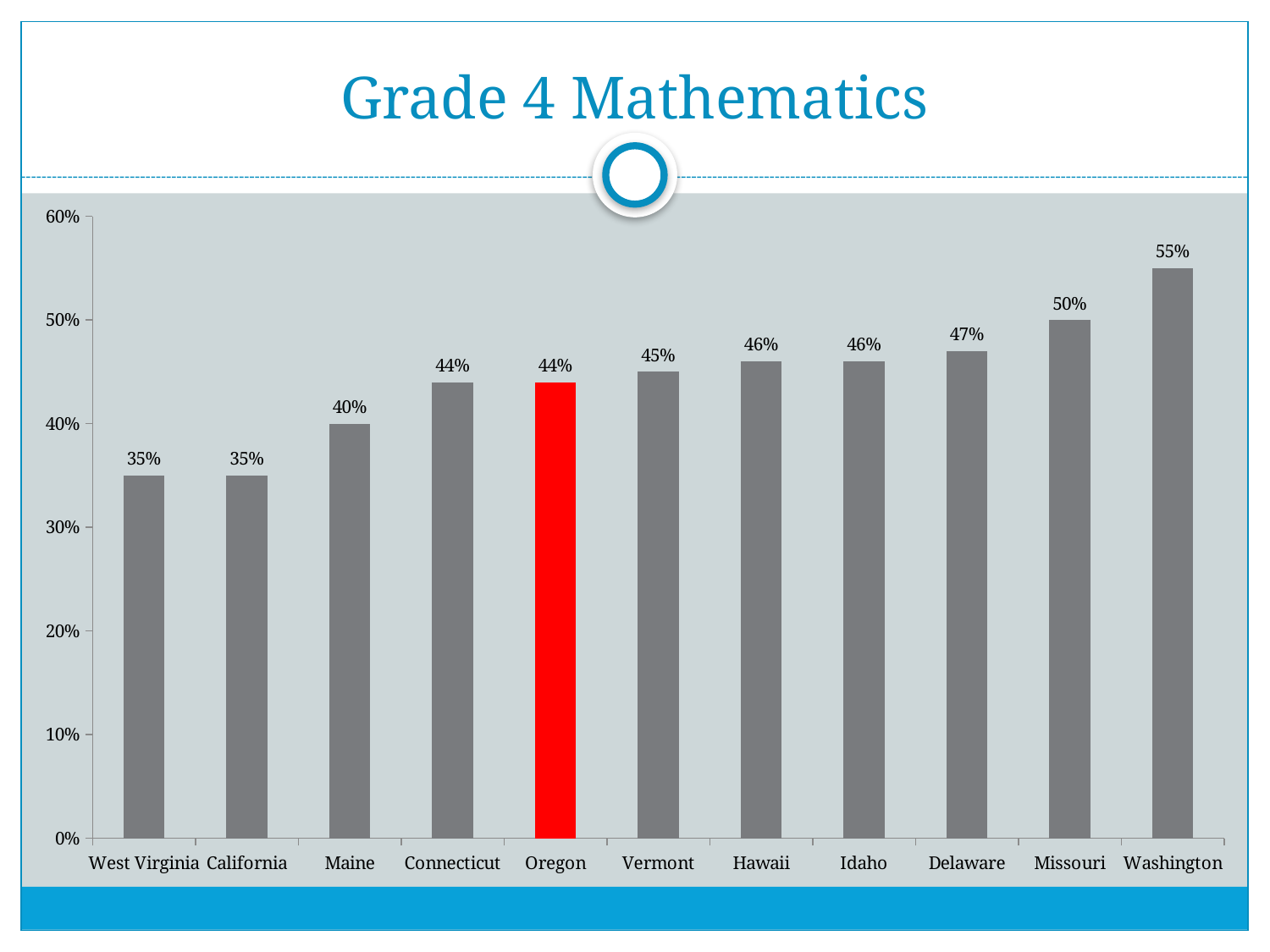
What is the difference between the values for Missouri and Maine? 10% Do the values generally rise or fall from left to right along the x axis? rise What is the value for Oregon? 44% How many states are shown on the chart? 11 Which is larger, the value for Delaware or the value for Vermont? Delaware What kind of chart is shown on the slide? bar chart What is the value for Washington? 55% Is the value for Missouri greater or less than 40%? greater What is the difference between the values for Washington and Oregon? 11% What is the value for Maine? 40% Which state has the highest value? Washington Which state's bar is coloured red? Oregon